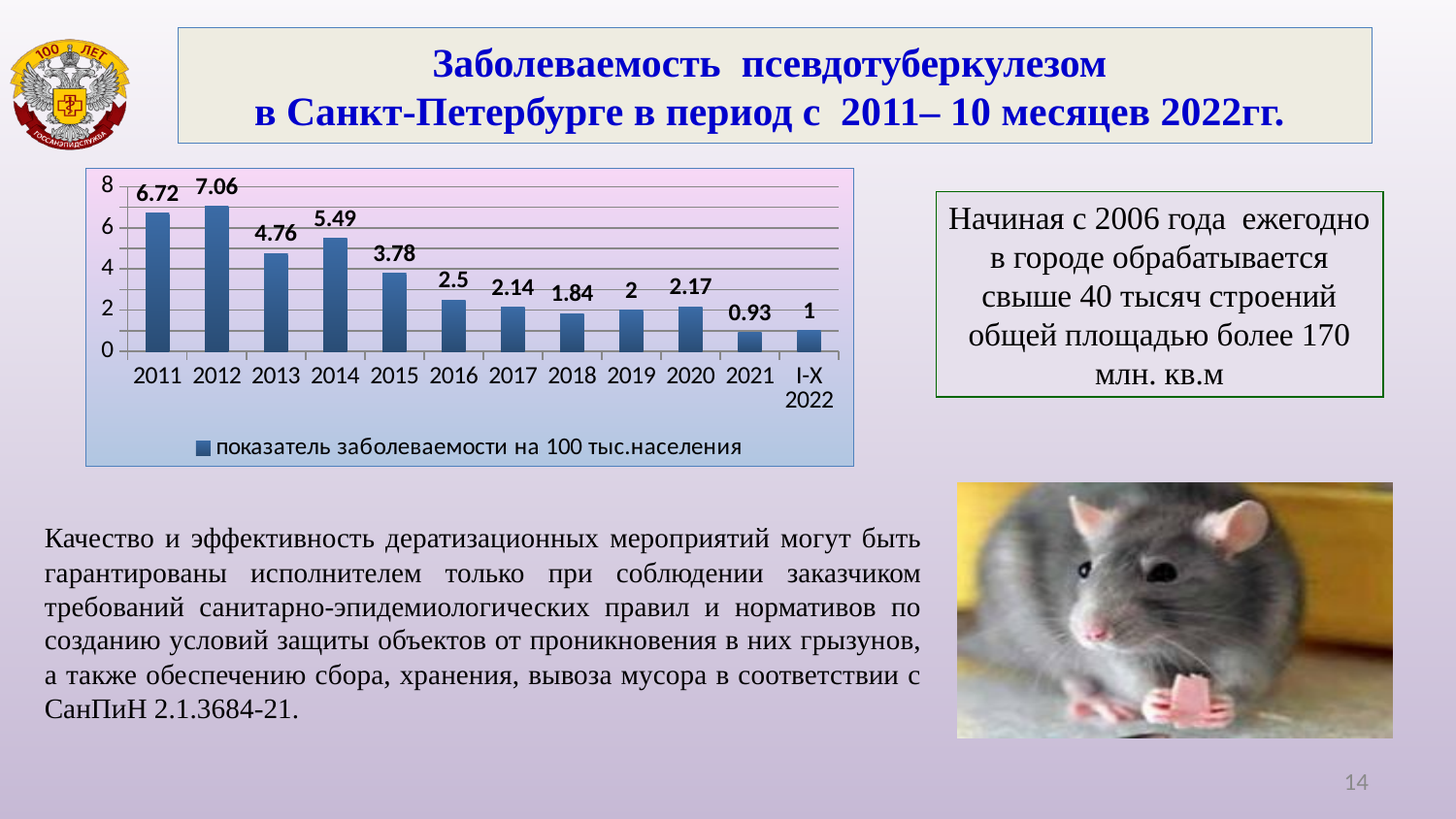
What is the value for 2021? 0.93 Which category has the lowest value? 2021 Which is larger, the value for 2014 or the value for 2013? 2014 What is the difference between the values for 2011 and 2013? 1.96 What is the value for 2012? 7.06 How many categories are shown on the x axis? 12 How many series does the legend list? 1 Which year has the highest value? 2012 What is the value for 2015? 3.78 What is the legend entry of the chart? показатель заболеваемости на 100 тыс.населения What is the value for I-X 2022? 1 What kind of chart is shown on the slide? bar chart